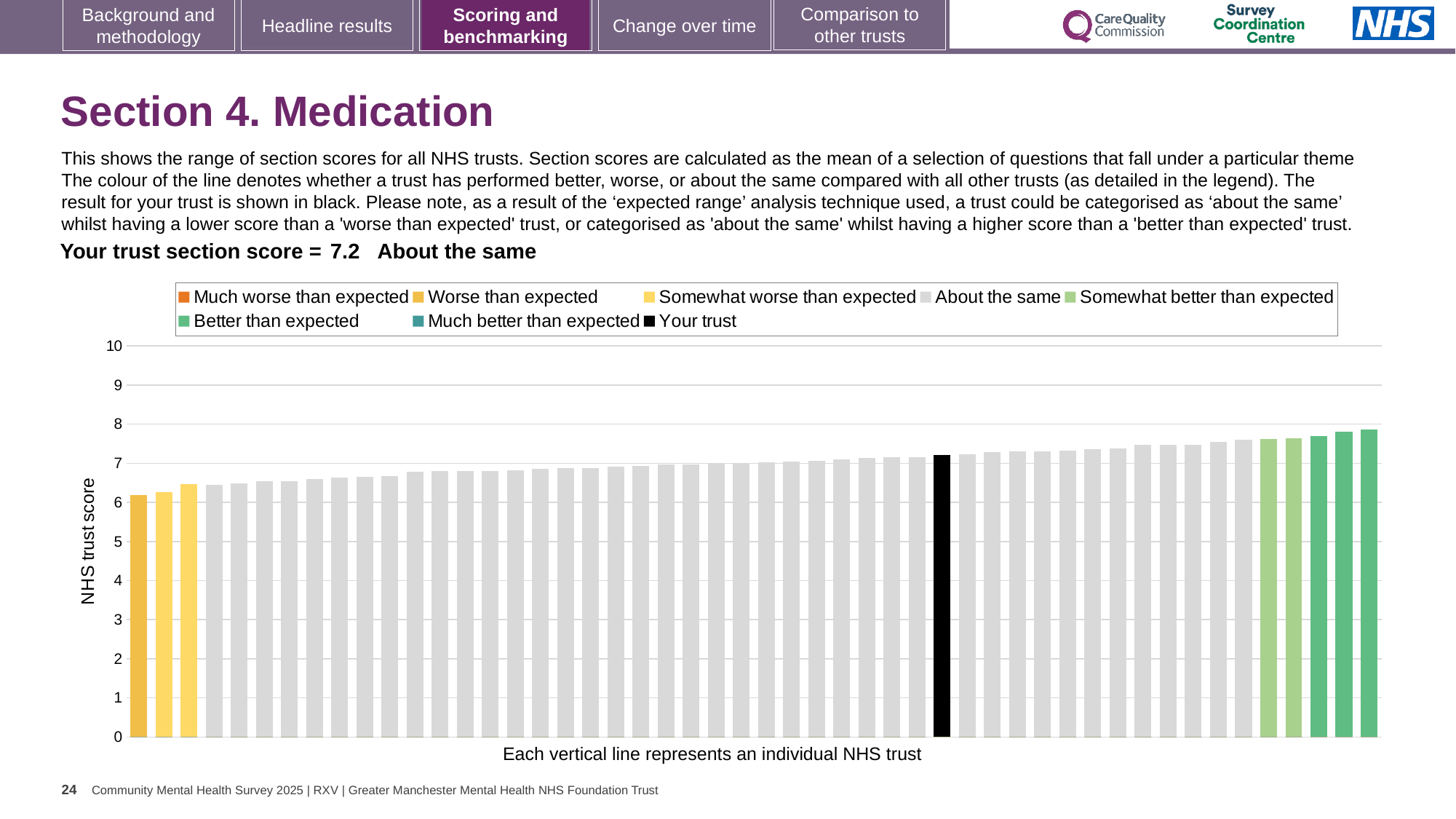
Is the value for your trust (the black bar) greater or less than 7? greater How many entries does the chart legend list? 8 What is the section score for your trust shown on the slide? 7.2 How many bars are coloured in the 'Worse than expected' / 'Somewhat worse than expected' yellow shades? 3 Do the bar values rise or fall from left to right along the x axis? rise What colour is the bar representing your trust? black How many bars are coloured as 'Better than expected' (darker green)? 3 Is the value of the highest bar in the chart greater or less than 7? greater What is the label on the vertical axis of the chart? NHS trust score What kind of chart is shown on the slide? bar chart Is the value of the lowest bar in the chart greater or less than 7? less Which category is your trust's section score placed in? About the same